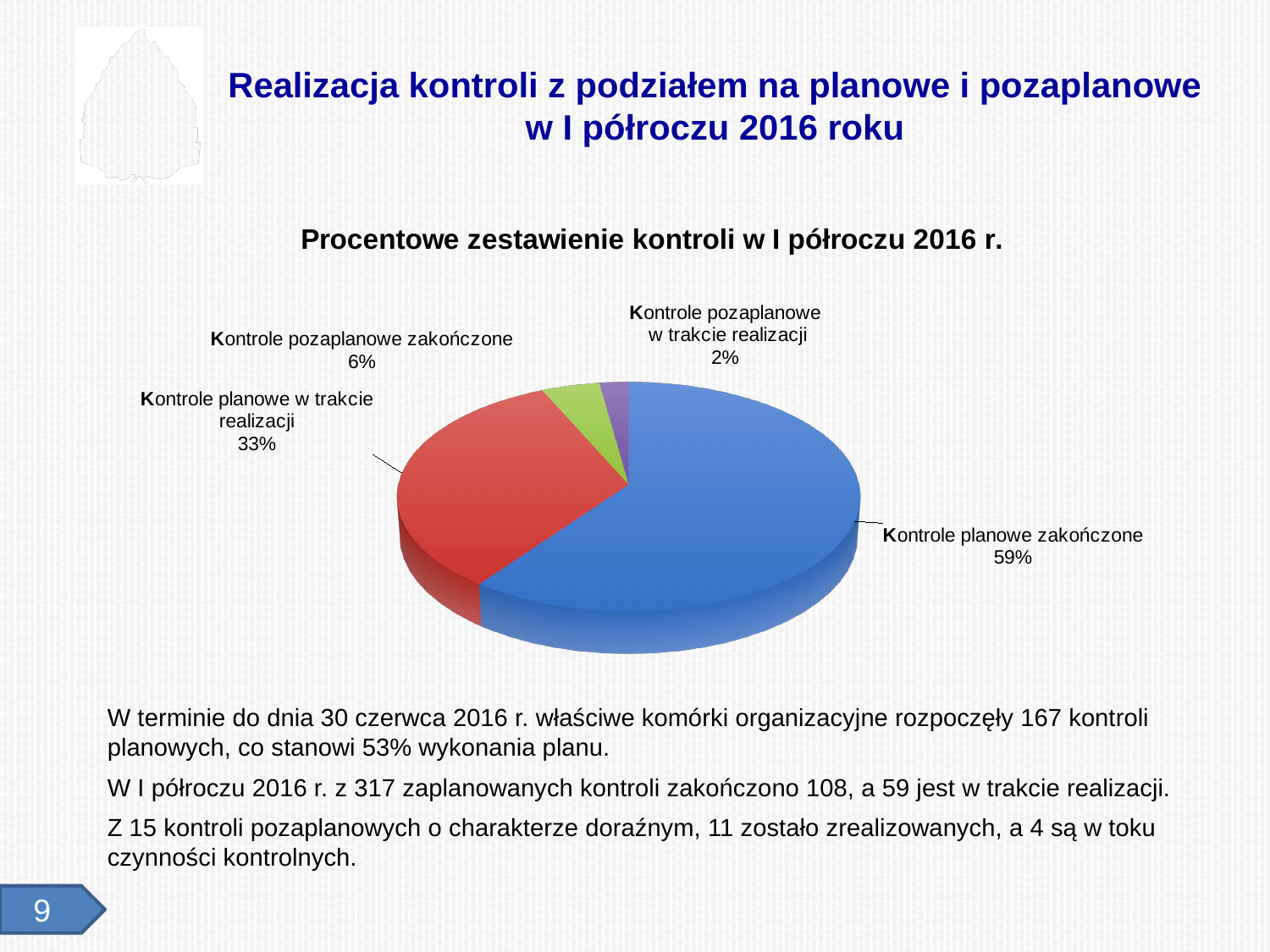
Which is larger: the share for 'Kontrole pozaplanowe zakończone' or for 'Kontrole pozaplanowe w trakcie realizacji'? Kontrole pozaplanowe zakończone How many categories are shown in the pie chart? 4 What share of the pie does 'Kontrole planowe zakończone' represent? 59% What colour is the slice for 'Kontrole planowe w trakcie realizacji'? Red What is the difference in percentage points between 'Kontrole planowe zakończone' and 'Kontrole planowe w trakcie realizacji'? 26 percentage points Which category has the largest slice of the pie? Kontrole planowe zakończone What share of the pie does 'Kontrole pozaplanowe zakończone' represent? 6% What share of the pie does 'Kontrole planowe w trakcie realizacji' represent? 33% What is the title of the chart? Procentowe zestawienie kontroli w I półroczu 2016 r. What type of chart is shown on the slide? Pie chart Which category has the smallest slice of the pie? Kontrole pozaplanowe w trakcie realizacji